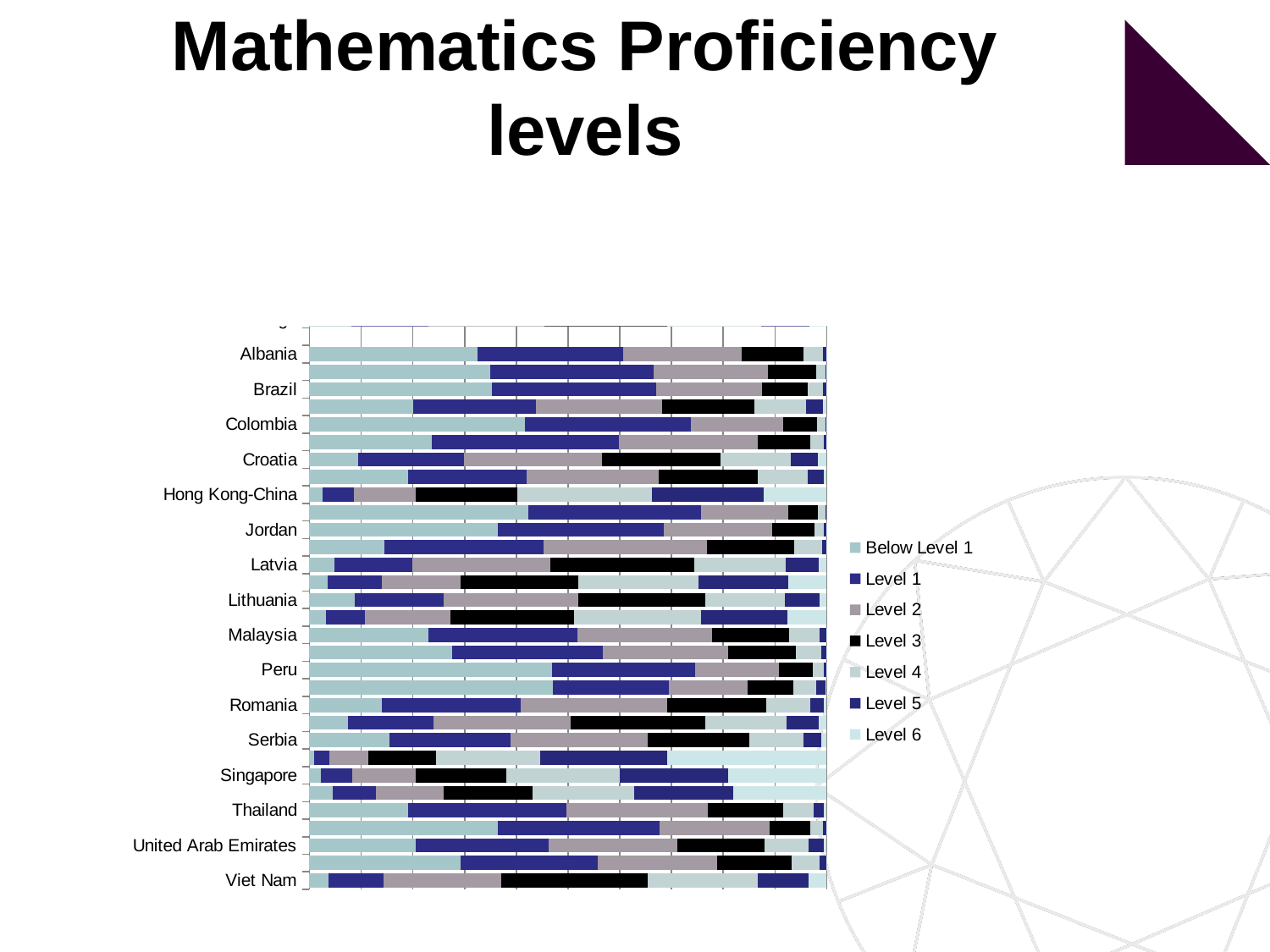
Is the Level 4 segment larger for Hong Kong-China or for Jordan? Hong Kong-China Is the Below Level 1 segment larger for Albania or for Hong Kong-China? Albania Is the Below Level 1 segment larger for Brazil or for Singapore? Brazil How many series does the chart legend list? 7 Which colour represents Level 3 in the chart legend? Black What kind of chart is shown on the slide? Stacked bar chart What is the title of the slide containing the chart? Mathematics Proficiency levels